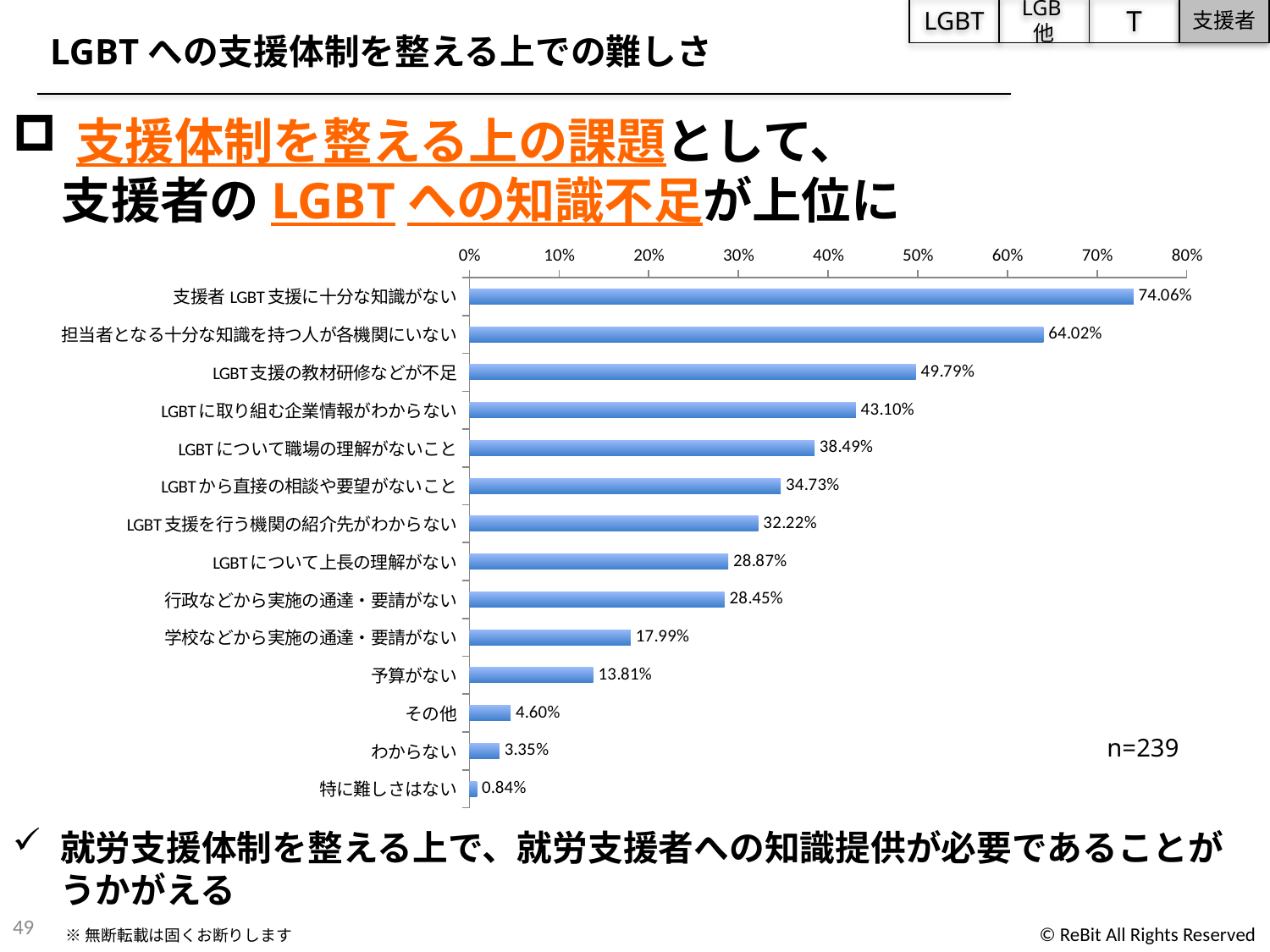
What sample size (n) is shown next to the chart? n=239 What is the value for わからない? 3.35% What is the value for 支援者 LGBT支援に十分な知識がない? 74.06% Is the value for LGBTに取り組む企業情報がわからない greater or less than 40%? greater Which category has the lowest value? 特に難しさはない Which category has the highest value? 支援者 LGBT支援に十分な知識がない What is the value for LGBT支援の教材研修などが不足? 49.79% What kind of chart is shown on the slide? bar chart Which is larger, the value for LGBTについて職場の理解がないこと or the value for LGBTから直接の相談や要望がないこと? LGBTについて職場の理解がないこと What is the difference between the values for 支援者 LGBT支援に十分な知識がない and 担当者となる十分な知識を持つ人が各機関にいない? 10.04% What is the value for 予算がない? 13.81% How many categories are shown in the chart? 14